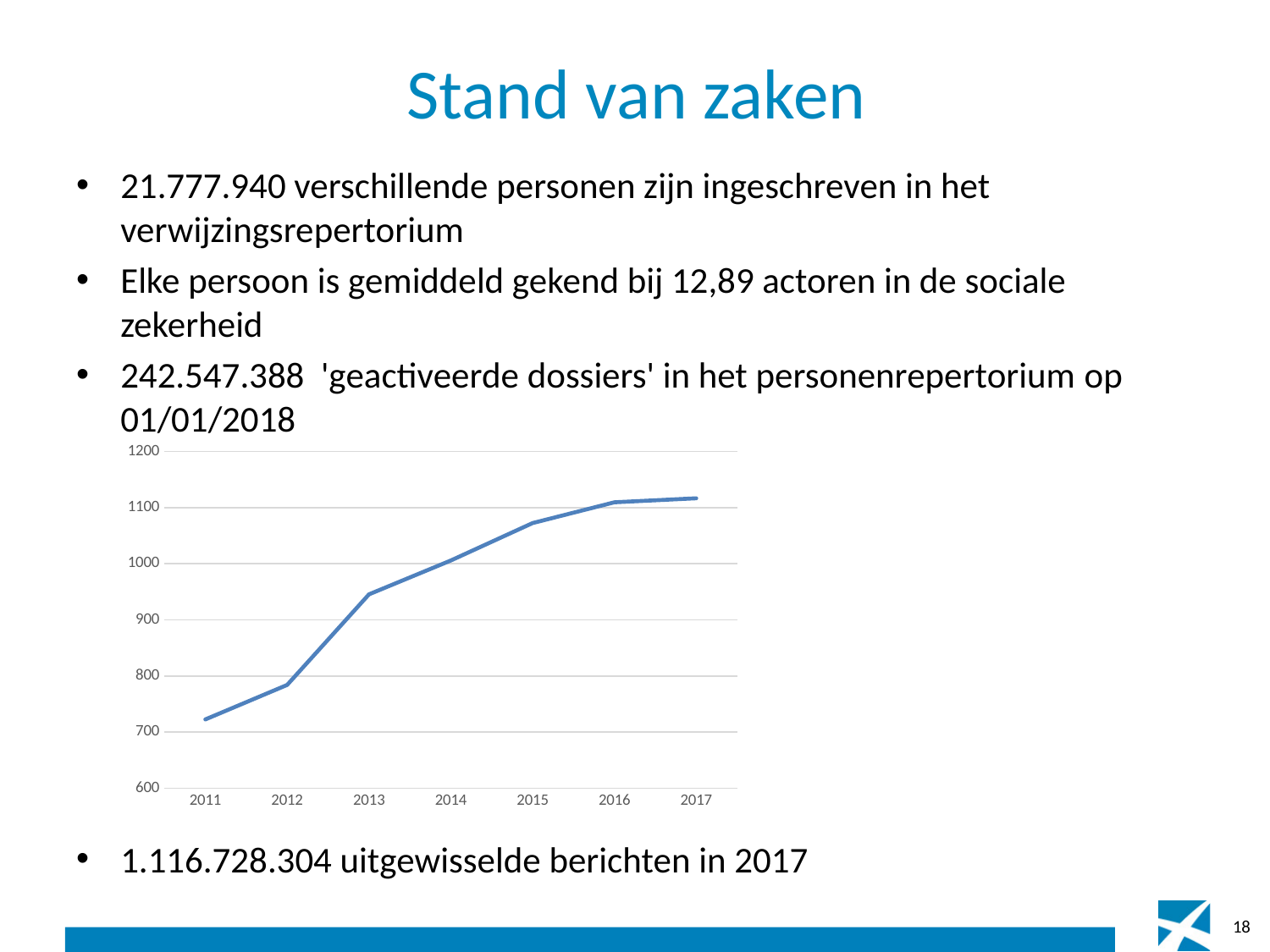
What kind of chart is shown on the slide? line chart Is the value for 2011 greater or less than 800? less Which year has the lowest value in the chart? 2011 Is the value for 2013 greater or less than 900? greater Is the value for 2012 greater or less than 700? greater How many years are plotted along the x axis of the chart? 7 Which year has the larger value, 2012 or 2014? 2014 Which year has the highest value in the chart? 2017 Do the values in the chart rise or fall from 2011 to 2017? rise What is the first year shown on the x axis of the chart? 2011